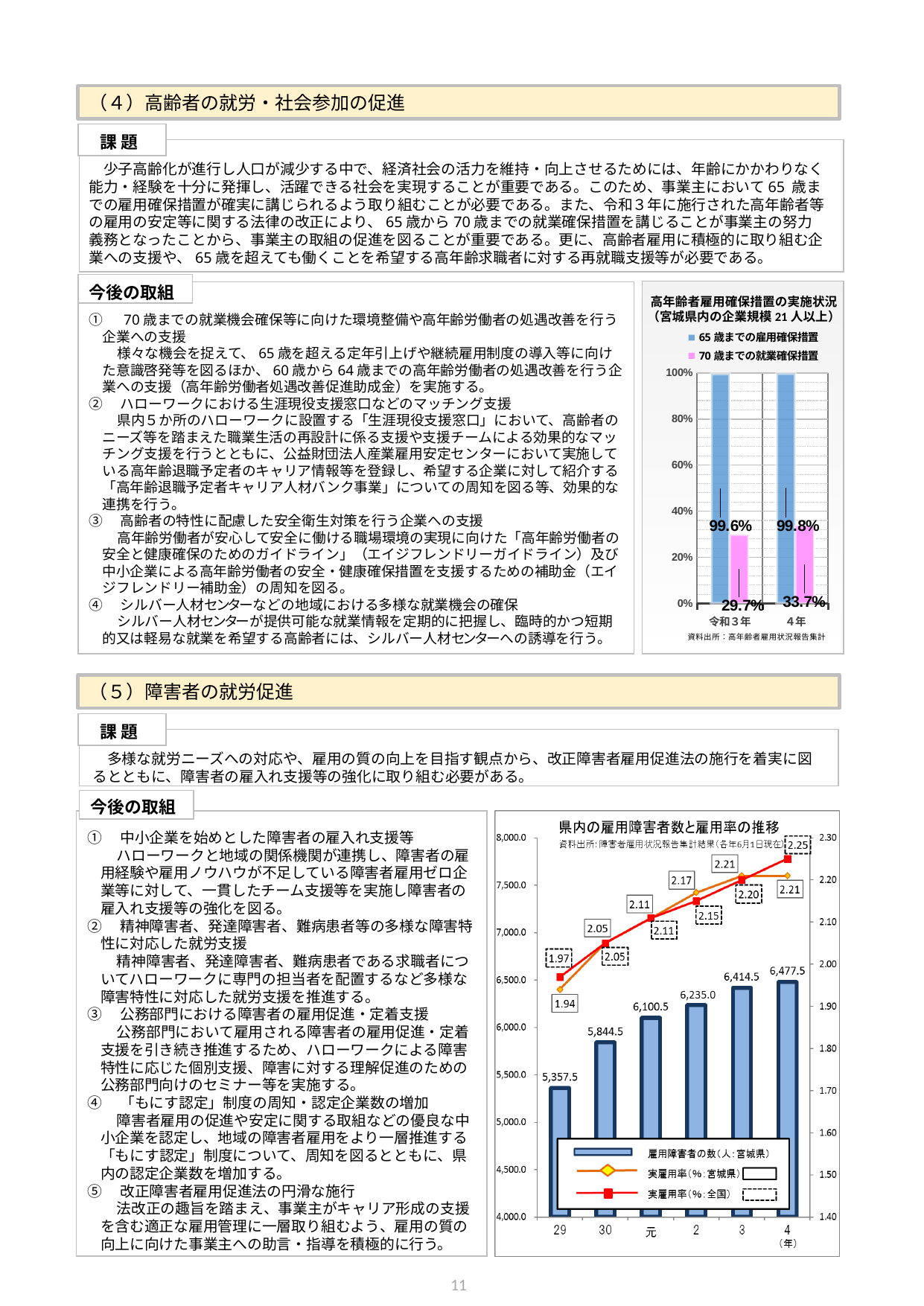
In the chart titled 高年齢者雇用確保措置の実施状況, what is the value for 70歳までの就業確保措置 in 4年? 33.7% In the chart titled 県内の雇用障害者数と雇用率の推移, what is the difference in 雇用障害者の数 between 4 and 3? 63.0 In the chart titled 県内の雇用障害者数と雇用率の推移, how many series does the legend list? 3 In the chart titled 高年齢者雇用確保措置の実施状況, what is the value for 65歳までの雇用確保措置 in 令和3年? 99.6% In the chart titled 県内の雇用障害者数と雇用率の推移, which year has the lowest 雇用障害者の数? 29 In the chart titled 高年齢者雇用確保措置の実施状況, how many series does the legend list? 2 In the chart titled 高年齢者雇用確保措置の実施状況, what is the difference between the 70歳までの就業確保措置 values for 4年 and 令和3年? 4.0% In the chart titled 県内の雇用障害者数と雇用率の推移, which year has the highest 雇用障害者の数? 4 In the chart titled 高年齢者雇用確保措置の実施状況, is the value for 70歳までの就業確保措置 in 令和3年 greater or less than 40%? less In the chart titled 県内の雇用障害者数と雇用率の推移, does 雇用障害者の数 rise or fall from 29 to 4? rise In the chart titled 県内の雇用障害者数と雇用率の推移, what is the value of 雇用障害者の数 for 30? 5,844.5 In the chart titled 県内の雇用障害者数と雇用率の推移, what is the 実雇用率(%:全国) value for 4? 2.25